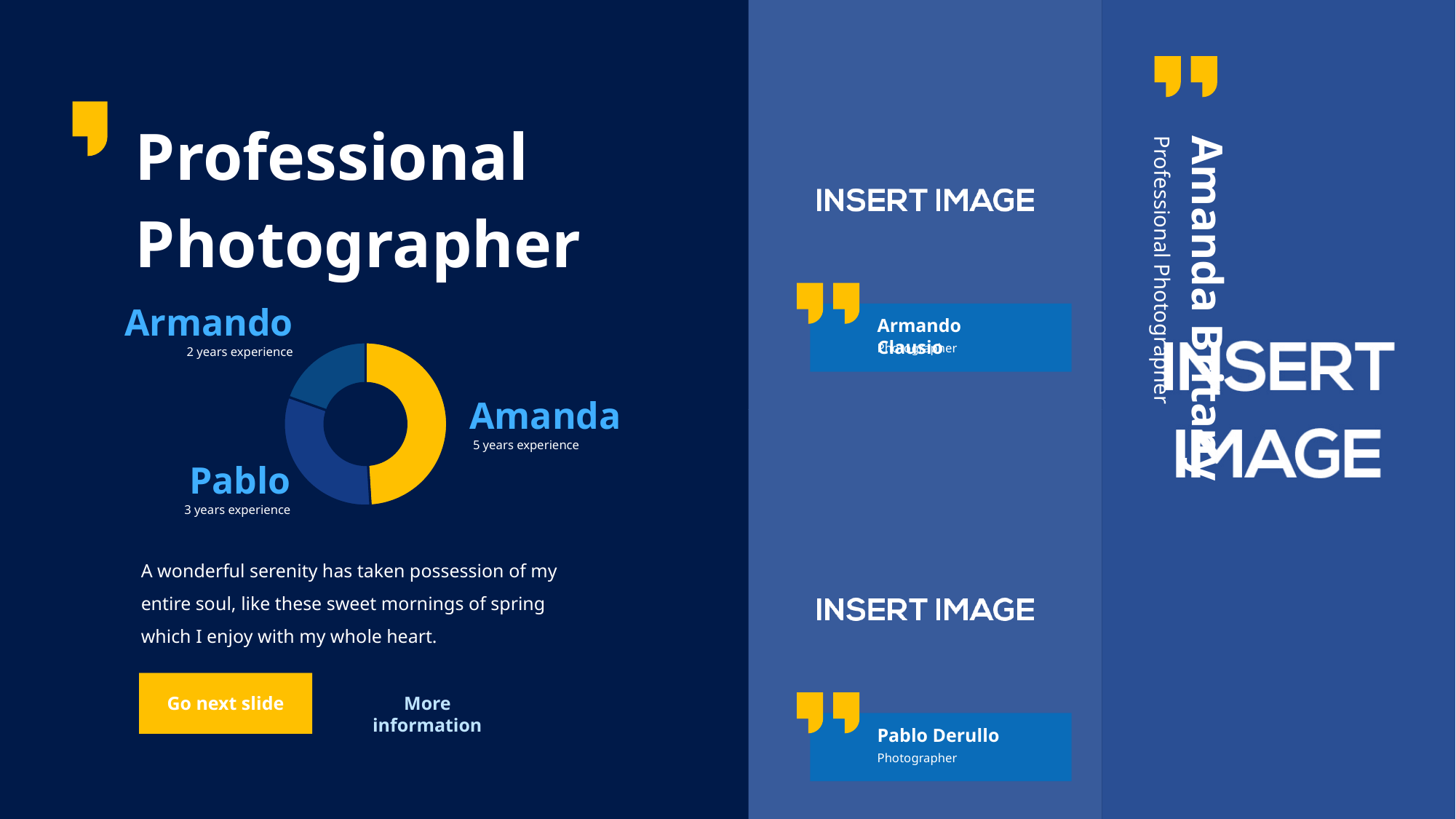
Who has more years of experience, Pablo or Armando? Pablo How many years of experience does Amanda have according to the chart? 5 years experience How many more years of experience does Amanda have than Pablo? 2 years Which colour is used for Amanda's segment in the doughnut chart? Yellow How many years of experience does Armando have according to the chart? 2 years experience Which person has the fewest years of experience in the chart? Armando What is the combined number of years of experience across all three people in the chart? 10 years How many segments does the doughnut chart have? 3 How many years of experience does Pablo have according to the chart? 3 years experience What kind of chart is shown on the slide? Doughnut chart Which person has the most years of experience in the chart? Amanda What share of the total years of experience in the chart does Amanda account for? 50%